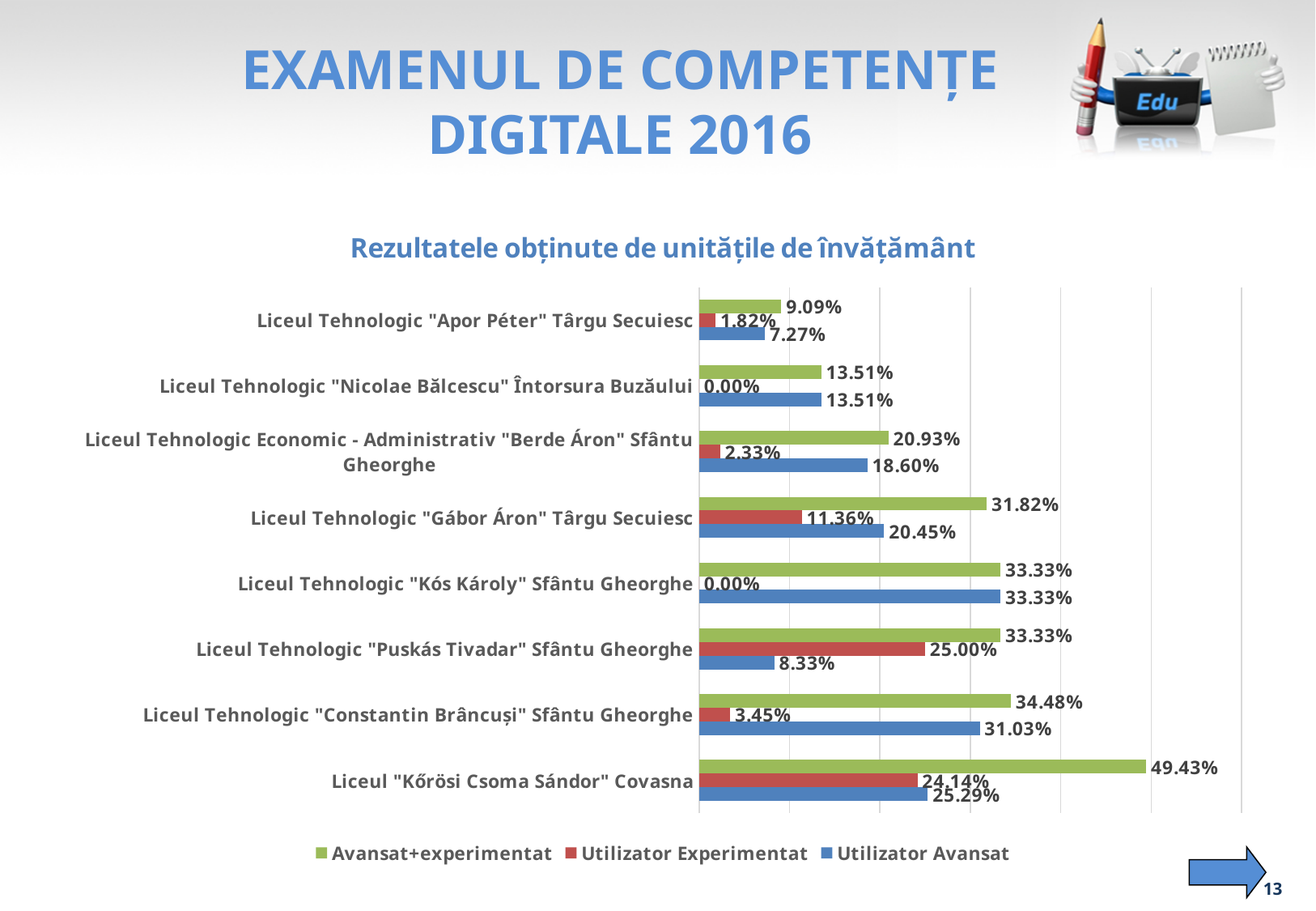
How many schools (categories) are shown in the chart? 8 What is the Utilizator Avansat value for Liceul Tehnologic "Constantin Brâncuși" Sfântu Gheorghe? 31.03% Which school has the highest Avansat+experimentat value? Liceul "Kőrösi Csoma Sándor" Covasna Which school has the lowest Avansat+experimentat value? Liceul Tehnologic "Apor Péter" Târgu Secuiesc What is the Avansat+experimentat value for Liceul "Kőrösi Csoma Sándor" Covasna? 49.43% What is the Utilizator Experimentat value for Liceul Tehnologic "Gábor Áron" Târgu Secuiesc? 11.36% How many series does the legend list? 3 Which is larger for Liceul Tehnologic "Puskás Tivadar" Sfântu Gheorghe: the Utilizator Experimentat value or the Utilizator Avansat value? Utilizator Experimentat Which school has the highest Utilizator Experimentat value? Liceul Tehnologic "Puskás Tivadar" Sfântu Gheorghe What is the title of the chart? Rezultatele obținute de unitățile de învățământ What kind of chart is shown on the slide? bar chart What is the difference between the Avansat+experimentat and Utilizator Avansat values for Liceul Tehnologic "Gábor Áron" Târgu Secuiesc? 11.37%